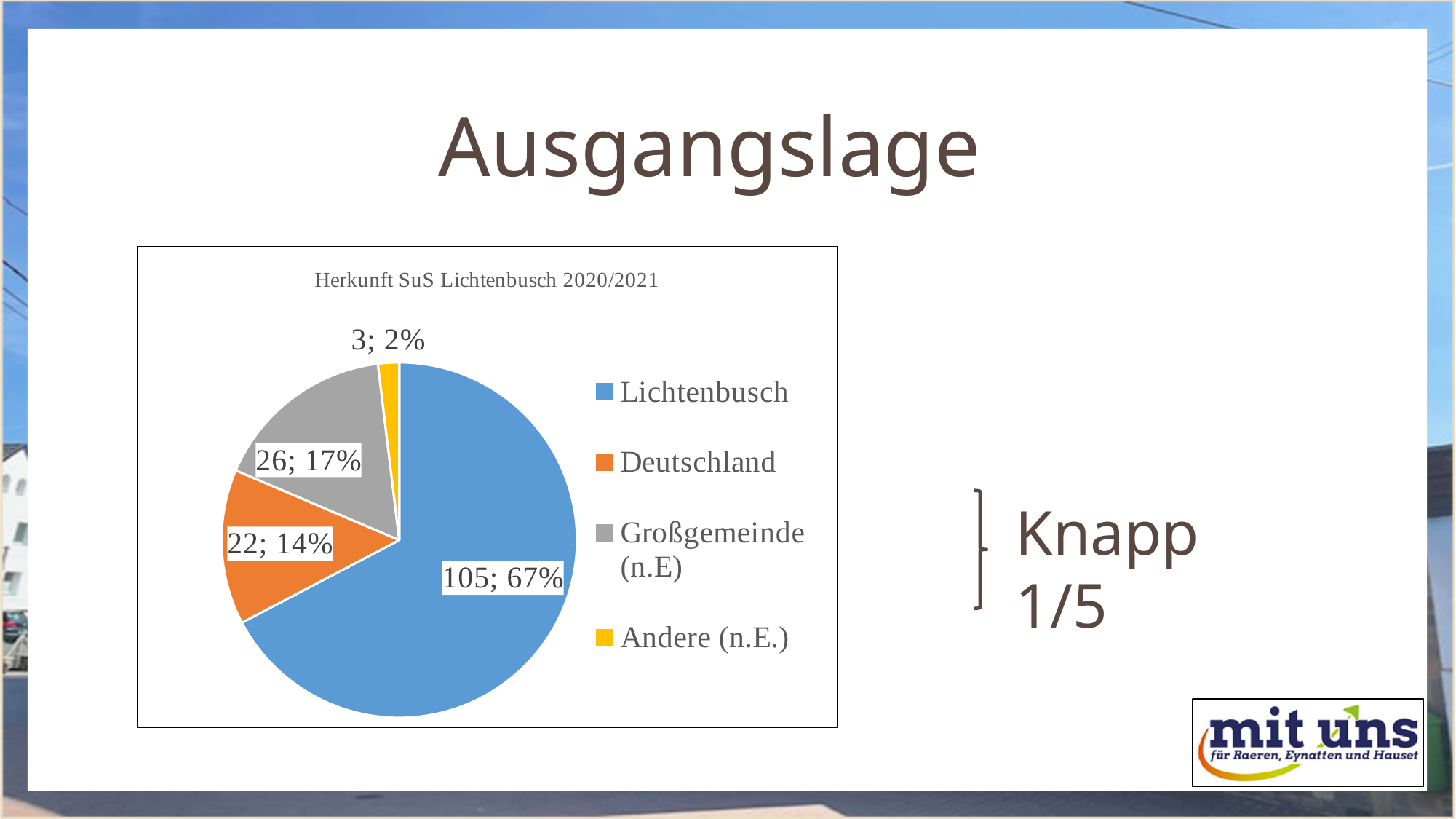
What kind of chart is shown on the slide? Pie chart What is the title of the chart? Herkunft SuS Lichtenbusch 2020/2021 What share of the pie does Lichtenbusch represent? 67% What is the value for Deutschland? 22 What is the value for Großgemeinde (n.E)? 26 What is the difference between the values for Großgemeinde (n.E) and Deutschland? 4 What is the value for Andere (n.E.)? 3 What share of the pie does Großgemeinde (n.E) represent? 17% Which category has the smallest slice? Andere (n.E.) Which category has the largest slice? Lichtenbusch How many slices does the pie chart have? 4 What is the value for Lichtenbusch? 105